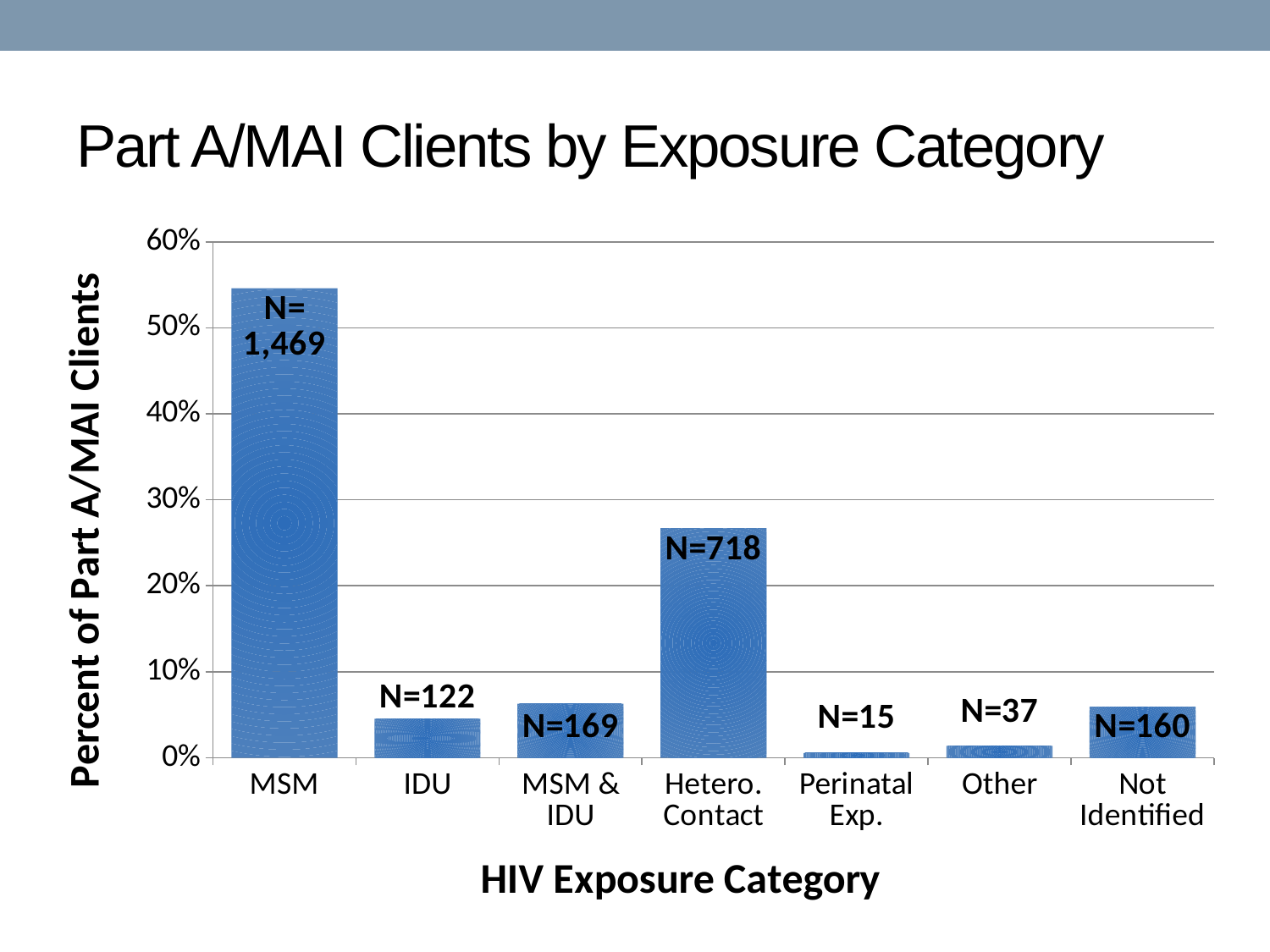
What is the N value printed on the Perinatal Exp. bar? N=15 What is the N value printed on the Hetero. Contact bar? N=718 Is the percent of Part A/MAI clients for Hetero. Contact greater or less than 30%? less How many exposure categories are shown on the x axis? 7 What is the N value printed on the MSM bar? N= 1,469 What is the N value printed on the Not Identified bar? N=160 Which exposure category has the lowest percent of Part A/MAI clients? Perinatal Exp. What is the difference between the N values for MSM & IDU and IDU? 47 Which exposure category has the highest percent of Part A/MAI clients? MSM Which has a larger percent of Part A/MAI clients, IDU or MSM & IDU? MSM & IDU Is the percent of Part A/MAI clients for MSM greater or less than 50%? greater What kind of chart is shown on the slide? bar chart